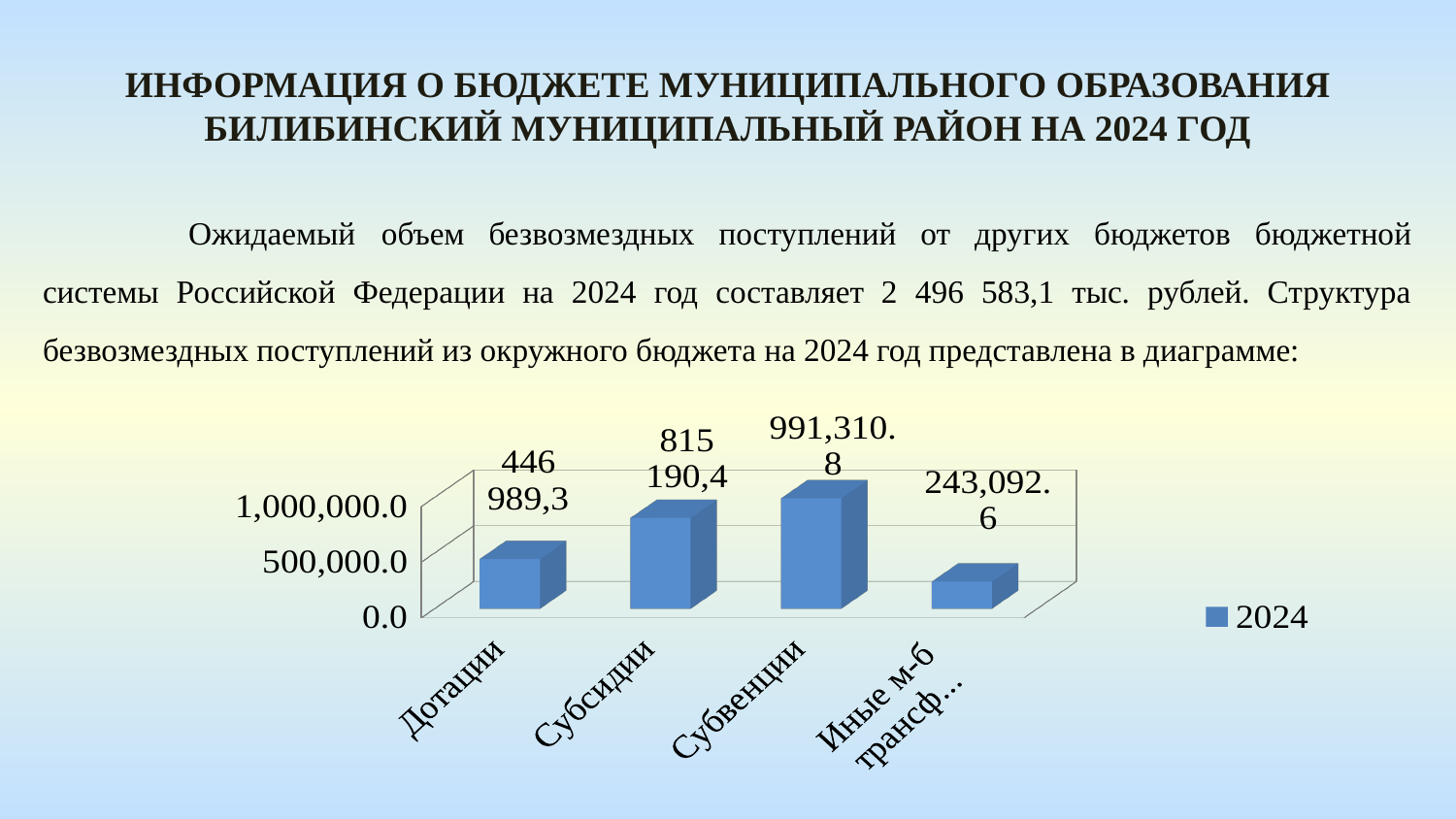
How many series does the legend list? 1 What value is shown for the rightmost bar (Иные м-б трансф...)? 243,092.6 What value is shown for Субсидии? 815 190,4 How many categories are shown on the x axis? 4 Is the value for Субвенции greater or less than 500,000? greater Which is larger, the value for Субсидии or the value for Дотации? Субсидии Is the value for Дотации greater or less than 500,000? less What kind of chart is shown on the slide? bar chart Which category has the highest value? Субвенции What value is shown for Субвенции? 991,310.8 Which category has the lowest value? Иные м-б трансф... What value is shown for Дотации? 446 989,3